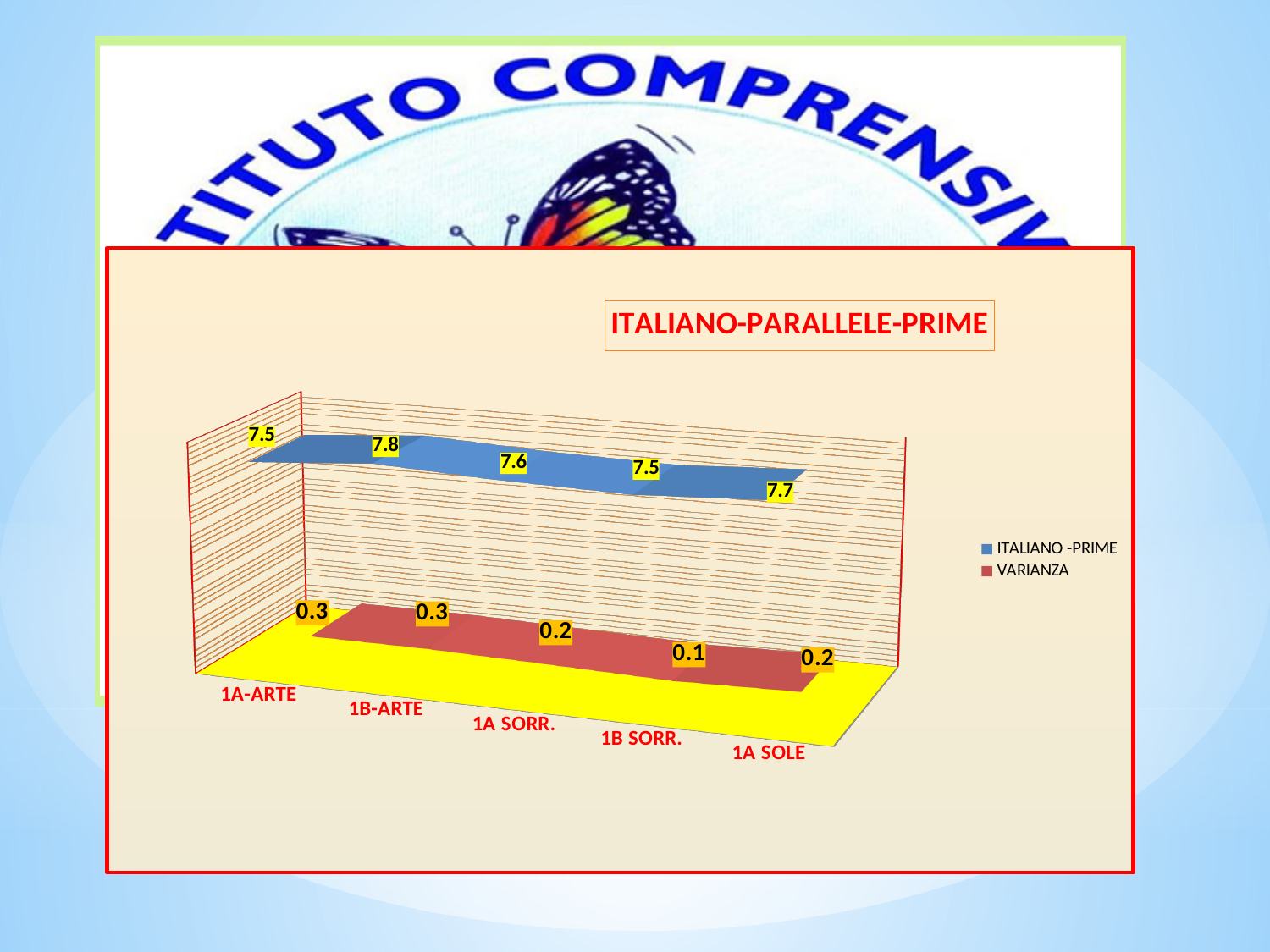
What is the VARIANZA value for 1B SORR.? 0.1 What is the ITALIANO -PRIME value for 1A SOLE? 7.7 Which category has the highest ITALIANO -PRIME value? 1B-ARTE How many series does the legend list? 2 Which is larger, the ITALIANO -PRIME value for 1A SORR. or for 1A SOLE? 1A SOLE What kind of chart is shown? 3D line chart What is the VARIANZA value for 1A-ARTE? 0.3 What is the difference between the ITALIANO -PRIME values for 1B-ARTE and 1B SORR.? 0.3 How many categories are shown on the x axis? 5 What is the title of the chart? ITALIANO-PARALLELE-PRIME Which category has the lowest VARIANZA value? 1B SORR. What is the ITALIANO -PRIME value for 1B-ARTE? 7.8